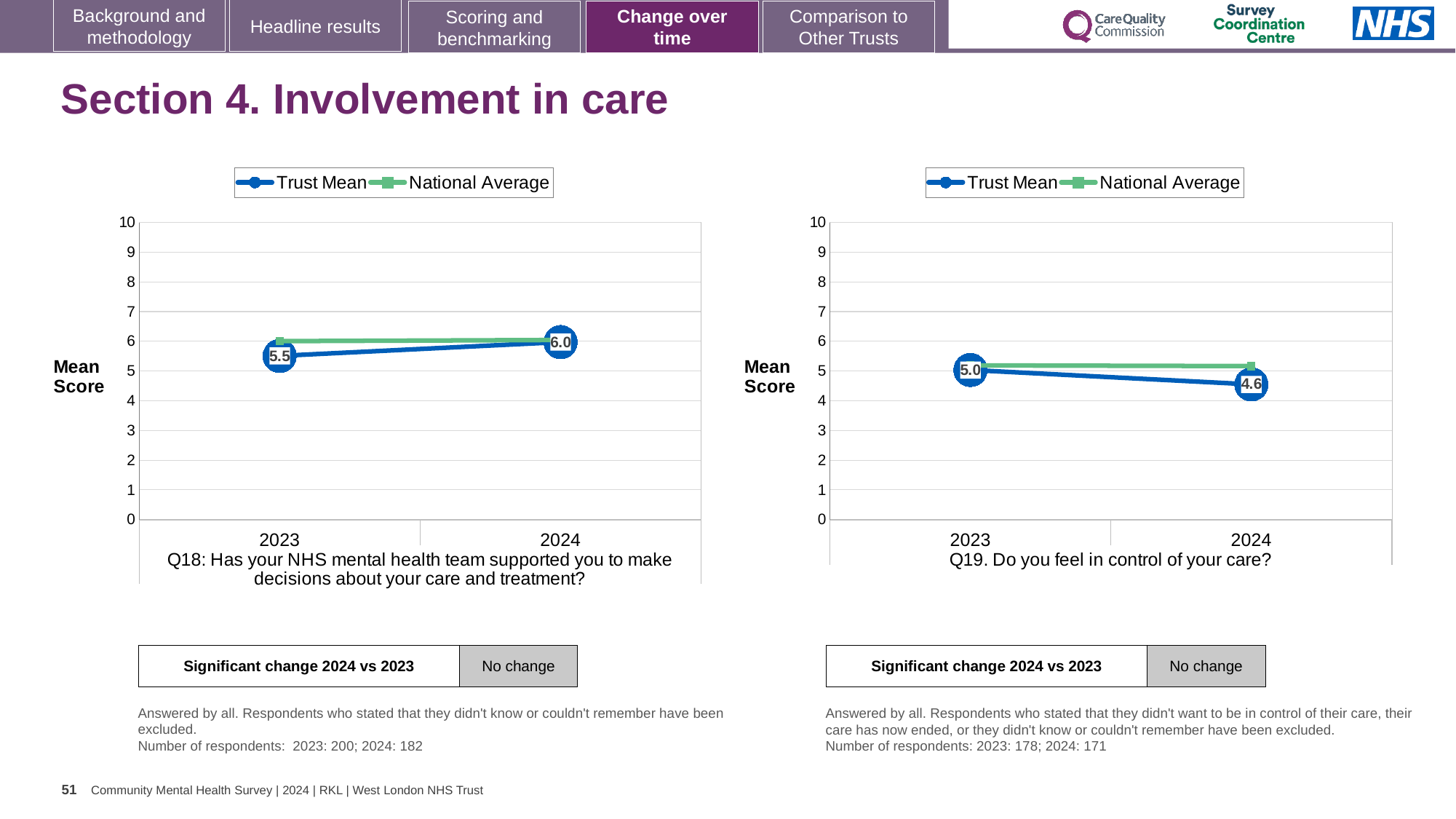
In the Q19 chart (right), which is larger in 2024: the Trust Mean or the National Average? National Average What type of chart is used for Q19 (right)? line chart In the Q18 chart (left), what is the Trust Mean score for 2023? 5.5 In the Q18 chart (left), by how much did the Trust Mean change from 2023 to 2024? 0.5 In the Q18 chart (left), what is the Trust Mean score for 2024? 6.0 In the Q19 chart (right), what is the Trust Mean score for 2023? 5.0 How many series does the legend of the Q18 chart (left) list? 2 In the Q19 chart (right), does the Trust Mean rise or fall from 2023 to 2024? fall In the Q19 chart (right), what is the Trust Mean score for 2024? 4.6 In the Q19 chart (right), what is the difference between the Trust Mean in 2023 and 2024? 0.4 In the Q19 chart (right), is the National Average value for 2024 greater or less than 4? greater In the Q18 chart (left), does the Trust Mean rise or fall from 2023 to 2024? rise